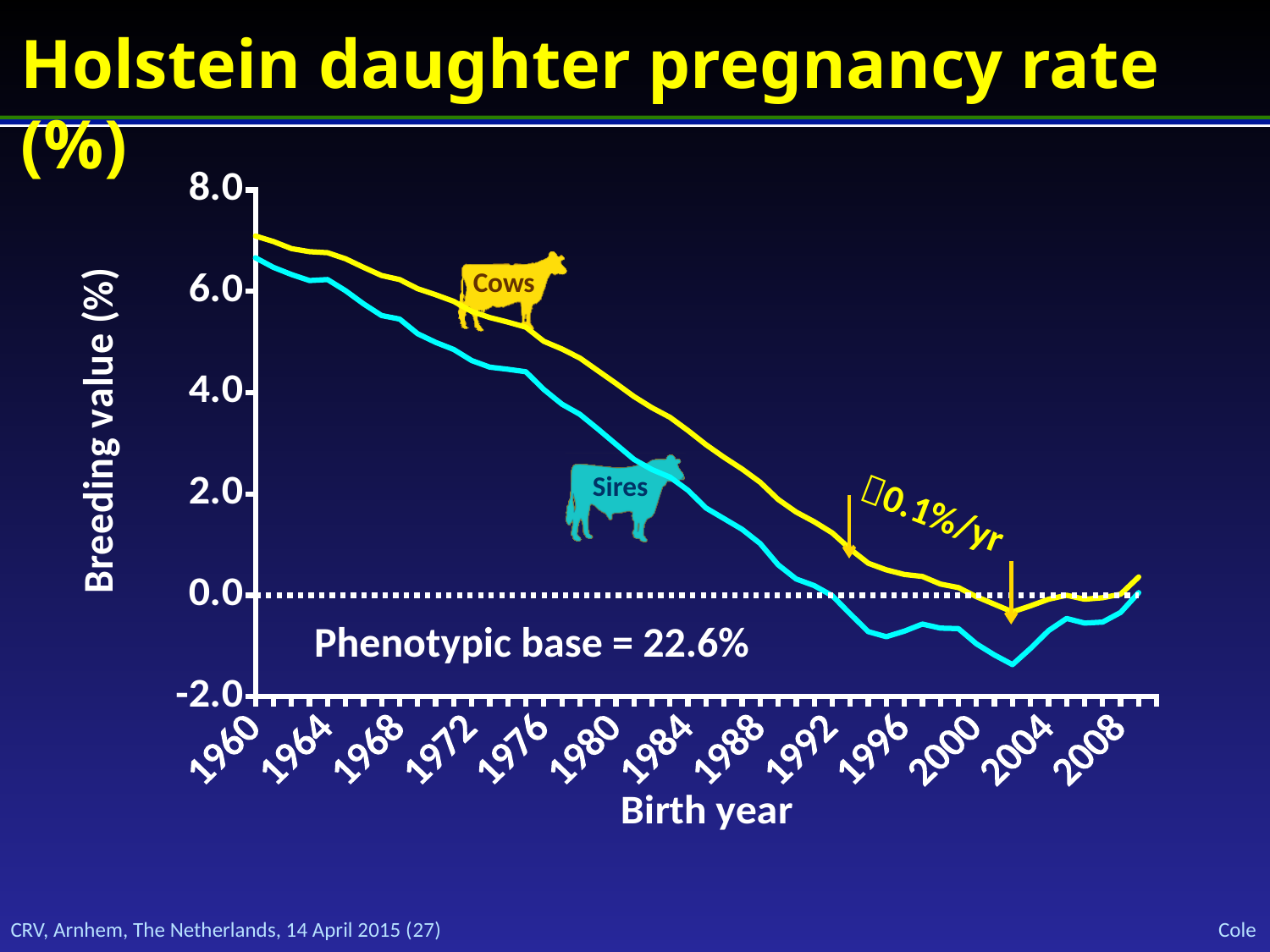
Is the breeding value for Cows at birth year 1960 greater or less than 6.0? greater Is the breeding value for Cows at birth year 1996 greater or less than 2.0? less Is the breeding value for Sires at birth year 1984 greater or less than 4.0? less At birth year 1980, which series has the higher breeding value, Cows or Sires? Cows What kind of chart is shown on the slide? line chart Which series has the lower breeding value at birth year 2000, Cows or Sires? Sires What is the label of the x axis? Birth year What are the names of the two series plotted on the chart? Cows and Sires Do the breeding values for Sires rise or fall from 1960 to 2004? fall Do the breeding values for Cows rise or fall from 1960 to 2004? fall